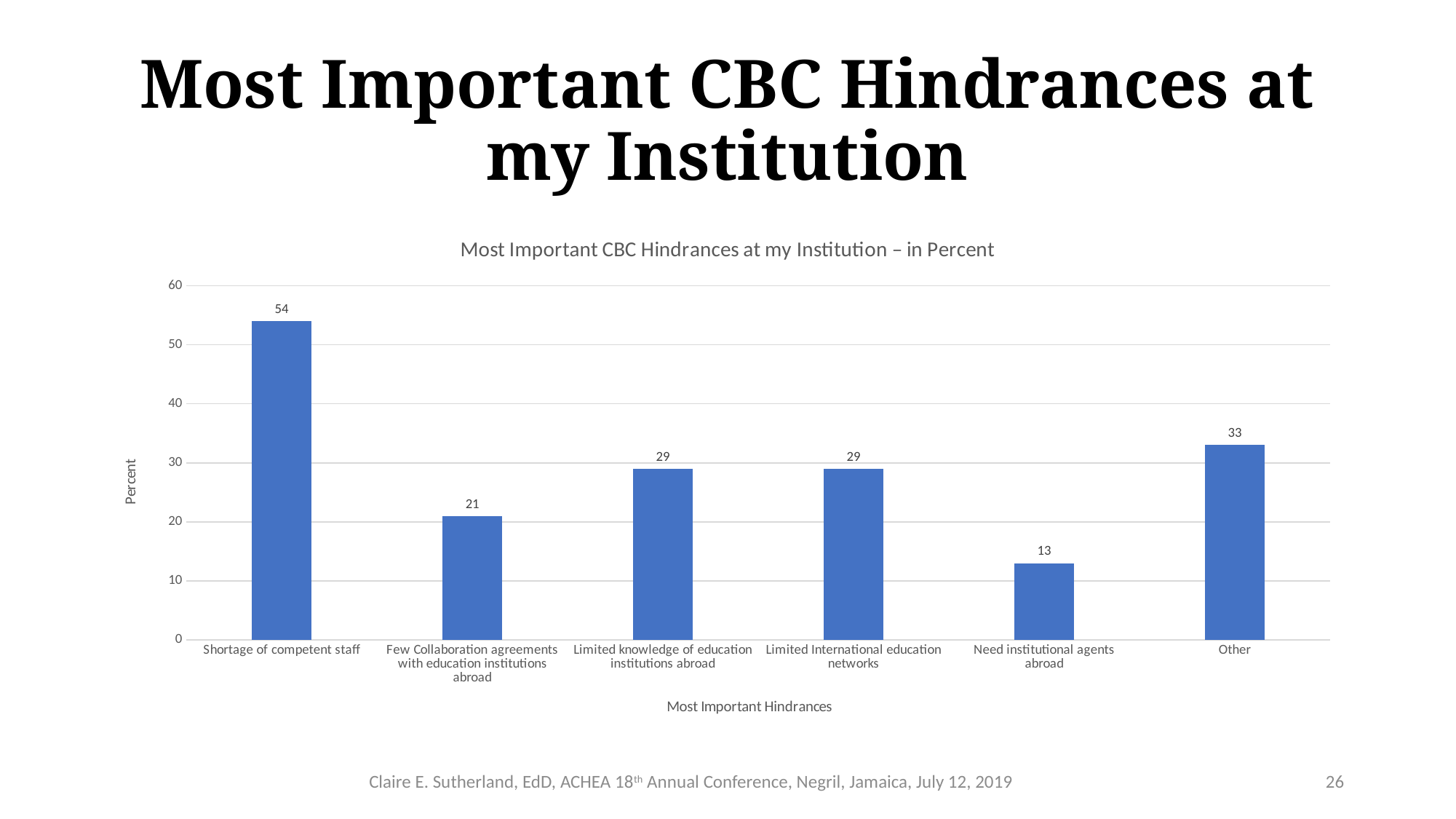
What is the value for Need institutional agents abroad? 13 What kind of chart is shown on the slide? Bar chart What is the value for Few Collaboration agreements with education institutions abroad? 21 Which category has the highest value? Shortage of competent staff Which category has the lowest value? Need institutional agents abroad Which is larger, the value for Other or the value for Limited knowledge of education institutions abroad? Other What is the value for Other? 33 What is the value for Shortage of competent staff? 54 What is the label of the y axis? Percent How many categories are shown on the x axis? 6 What is the difference between the values for Shortage of competent staff and Other? 21 What is the difference between the values for Limited International education networks and Need institutional agents abroad? 16